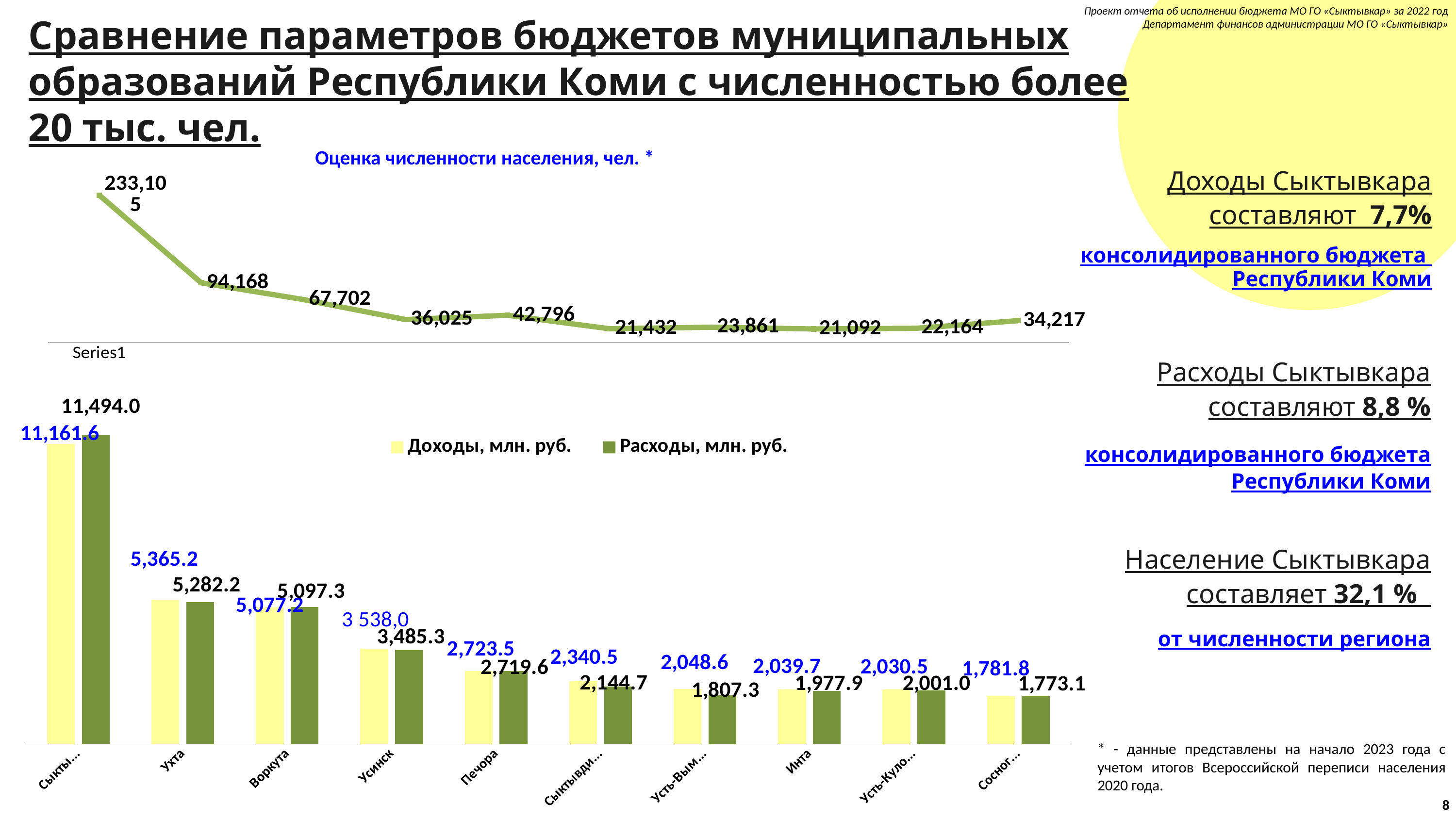
In the bottom bar chart, what is the value of Расходы, млн. руб. for Воркута? 5,097.3 In the bottom bar chart, what is the value of Доходы, млн. руб. for Печора? 2,723.5 In the top chart 'Оценка численности населения, чел.', what is the highest value shown? 233,105 In the bottom bar chart, which has higher Доходы: Ухта or Воркута? Ухта In the bottom bar chart, what is the difference between Доходы and Расходы for Ухта? 83.0 In the bottom bar chart, what is the value of Доходы, млн. руб. for Ухта? 5,365.2 In the bottom bar chart, which is larger for Воркута: Доходы or Расходы? Расходы How many series does the legend of the bottom bar chart list? 2 In the bottom bar chart, what is the value of Расходы, млн. руб. for Инта? 1,977.9 How many categories are shown in the bottom bar chart? 10 What type of chart is the top chart titled 'Оценка численности населения, чел.'? Line chart In the bottom bar chart, what is the value of Расходы, млн. руб. for Усинск? 3,485.3